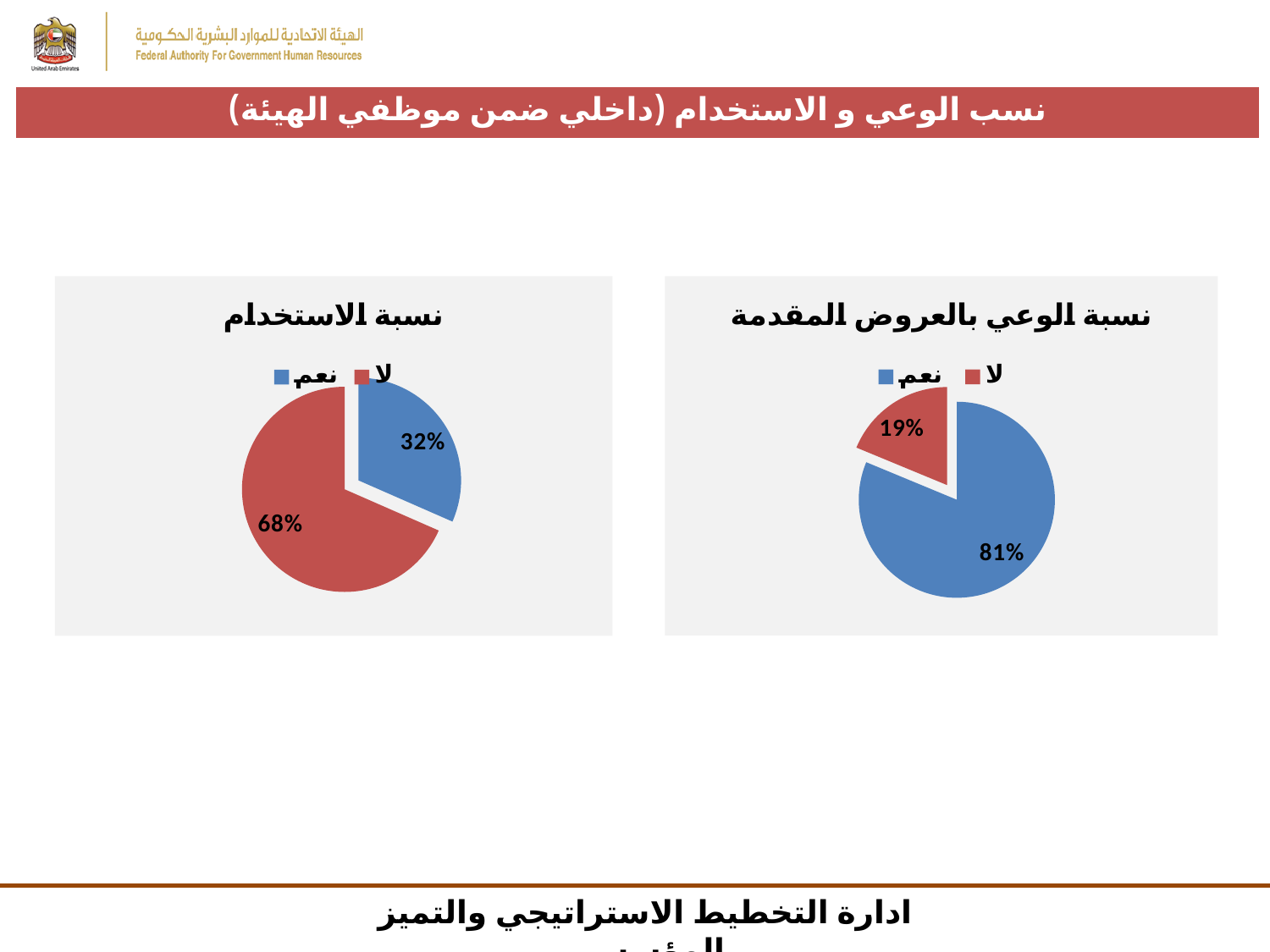
In the left pie chart (نسبة الاستخدام), which colour represents "نعم"? Blue In the left pie chart (نسبة الاستخدام), what is the difference between the "لا" share and the "نعم" share? 36% In the right pie chart (نسبة الوعي بالعروض المقدمة), what is the difference between the "نعم" share and the "لا" share? 62% In the pie chart titled "نسبة الاستخدام" (left), what is the share for "نعم"? 32% In the pie chart titled "نسبة الوعي بالعروض المقدمة" (right), what is the share for "نعم"? 81% What type of chart is used for "نسبة الاستخدام" on the left? Pie chart How many categories does the legend of the right pie chart (نسبة الوعي بالعروض المقدمة) list? 2 In the pie chart titled "نسبة الوعي بالعروض المقدمة" (right), what is the share for "لا"? 19% In the right pie chart (نسبة الوعي بالعروض المقدمة), which category has the smallest slice? لا In the pie chart titled "نسبة الاستخدام" (left), what is the share for "لا"? 68% In the left pie chart (نسبة الاستخدام), which category has the largest slice? لا Which is larger: the "نعم" share in the right chart (نسبة الوعي بالعروض المقدمة) or the "نعم" share in the left chart (نسبة الاستخدام)? The right chart (نسبة الوعي بالعروض المقدمة)